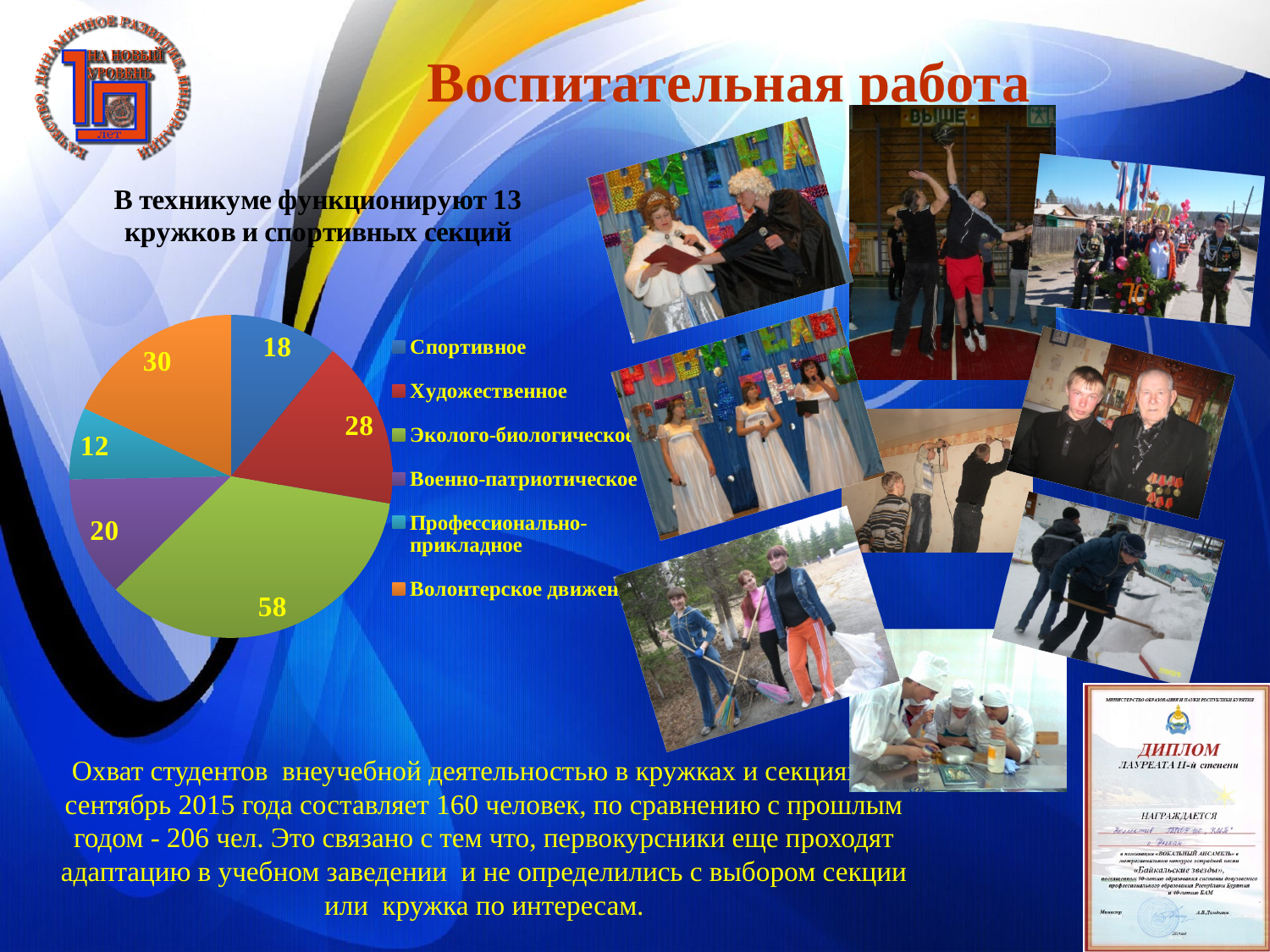
What is the value for Волонтерское движение in the pie chart? 30 What is the difference between the values for Эколого-биологическое and Художественное? 30 How many categories does the pie chart have? 6 What colour is the slice for Военно-патриотическое in the pie chart? purple What type of chart is shown on the slide? pie chart What is the value for Профессионально-прикладное in the pie chart? 12 Which category has the largest slice in the pie chart? Эколого-биологическое What is the value for Спортивное in the pie chart? 18 Which is larger: the value for Военно-патриотическое or the value for Художественное? Художественное What is the value for Эколого-биологическое in the pie chart? 58 Which category has the smallest slice in the pie chart? Профессионально-прикладное What is the total of all the values shown in the pie chart? 166